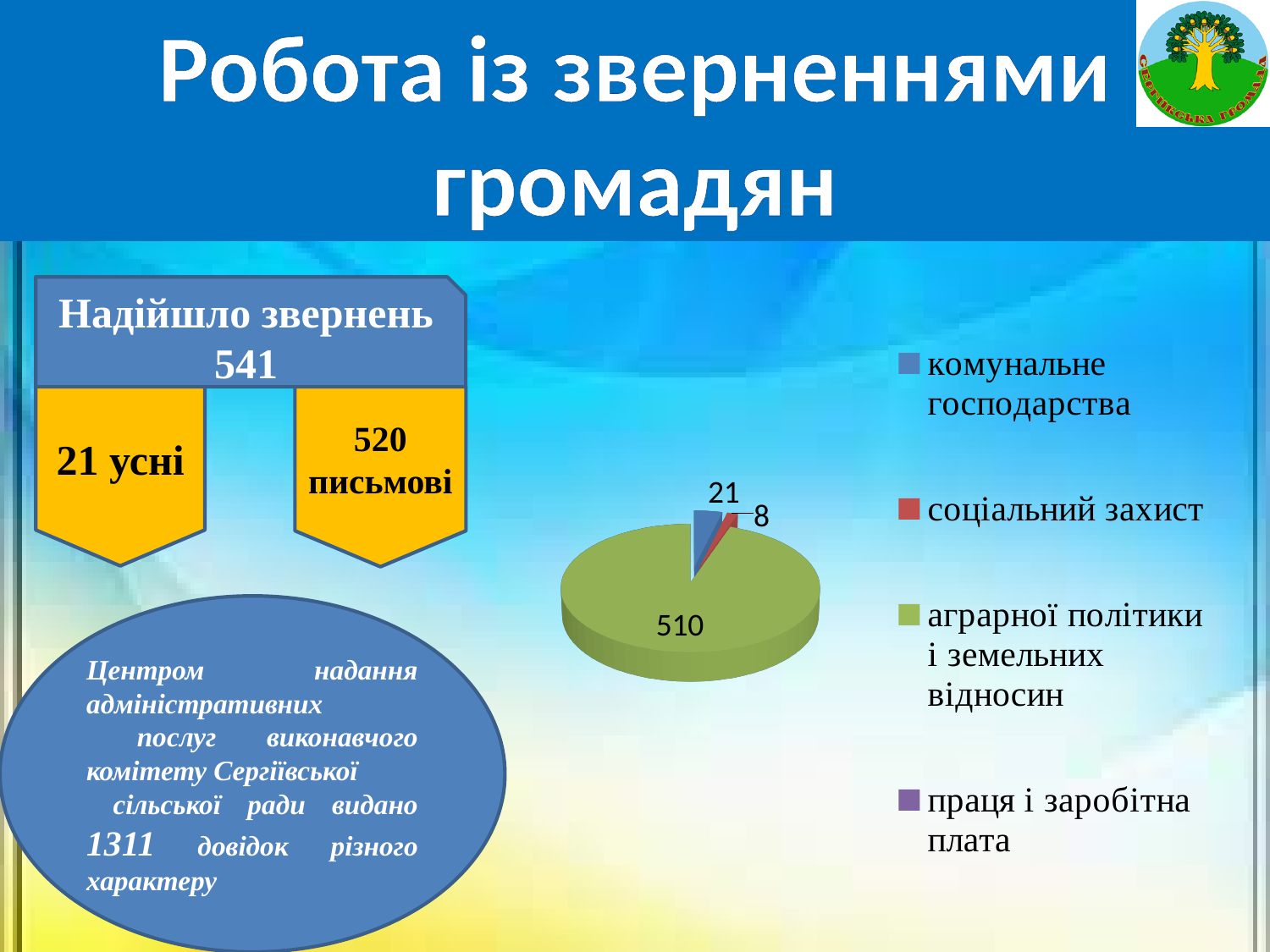
What is the difference between the values for "комунальне господарства" and "соціальний захист" in the pie chart? 13 What is the difference between the values for "аграрної політики і земельних відносин" and "комунальне господарства" in the pie chart? 489 What value is shown for the slice labelled "комунальне господарства" in the pie chart? 21 Which is larger in the pie chart: the value for "комунальне господарства" or the value for "соціальний захист"? комунальне господарства What value is shown for the slice labelled "соціальний захист" in the pie chart? 8 What kind of chart is shown on the slide? pie chart Which legend entry is shown in red in the pie chart? соціальний захист Which category has the largest slice in the pie chart? аграрної політики і земельних відносин What value is shown for the slice labelled "аграрної політики і земельних відносин" in the pie chart? 510 How many categories does the legend of the pie chart list? 4 What colour is the largest slice of the pie chart? green